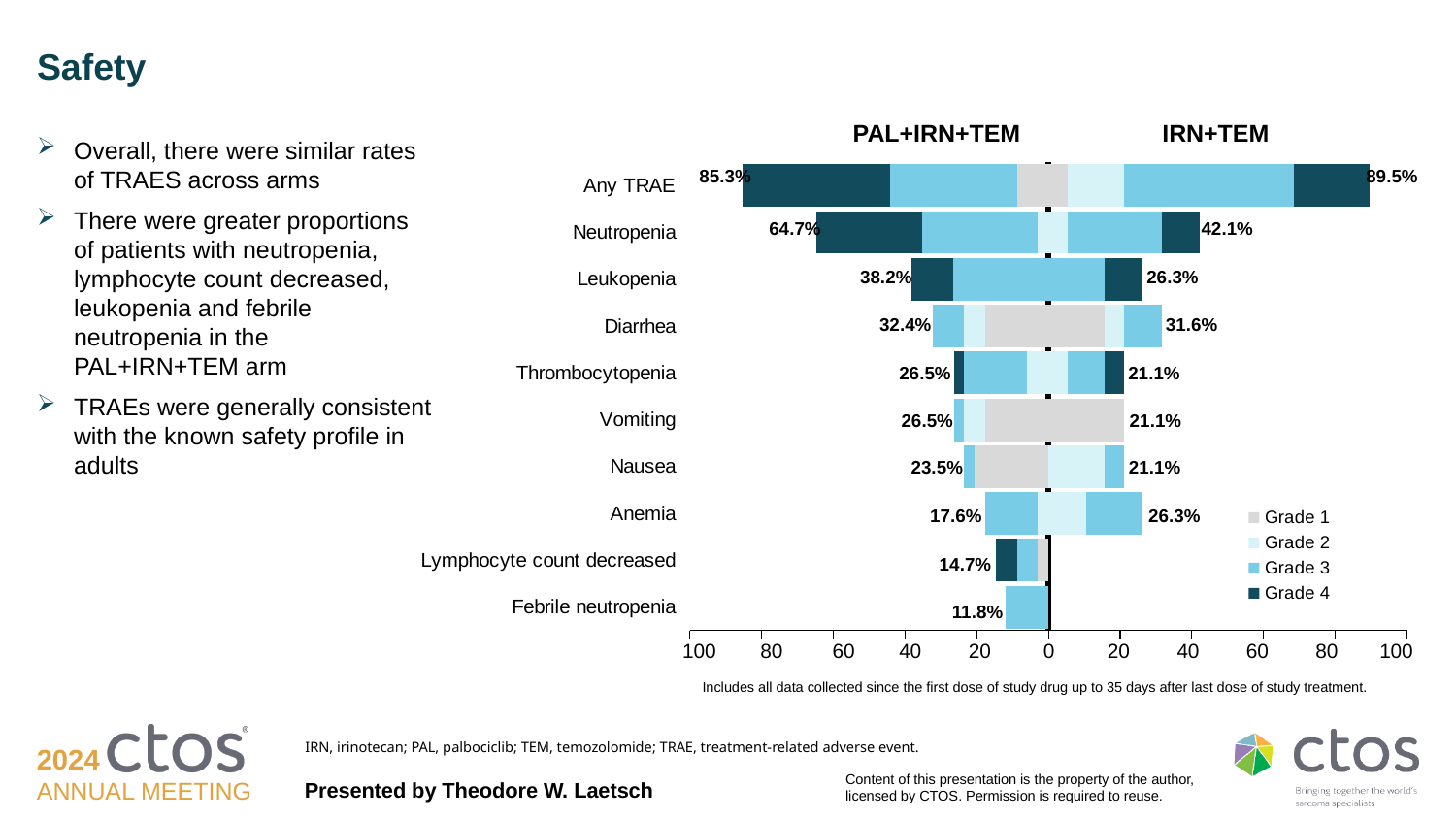
What is the rate of febrile neutropenia in the PAL+IRN+TEM arm? 11.8% Which adverse event has the lowest labelled rate in the PAL+IRN+TEM arm? Febrile neutropenia What is the rate of anemia in the IRN+TEM arm? 26.3% What is the total rate of Any TRAE in the IRN+TEM arm? 89.5% Which arm has the higher rate of leukopenia, PAL+IRN+TEM or IRN+TEM? PAL+IRN+TEM How many adverse event categories are listed on the chart? 10 Excluding Any TRAE, which adverse event has the highest rate in the PAL+IRN+TEM arm? Neutropenia What is the difference in neutropenia rate between the PAL+IRN+TEM arm (64.7%) and the IRN+TEM arm (42.1%)? 22.6 percentage points What is the rate of neutropenia in the PAL+IRN+TEM arm? 64.7% What is the total rate of Any TRAE in the PAL+IRN+TEM arm? 85.3% How many grade levels does the legend list? 4 What is the rate of neutropenia in the IRN+TEM arm? 42.1%